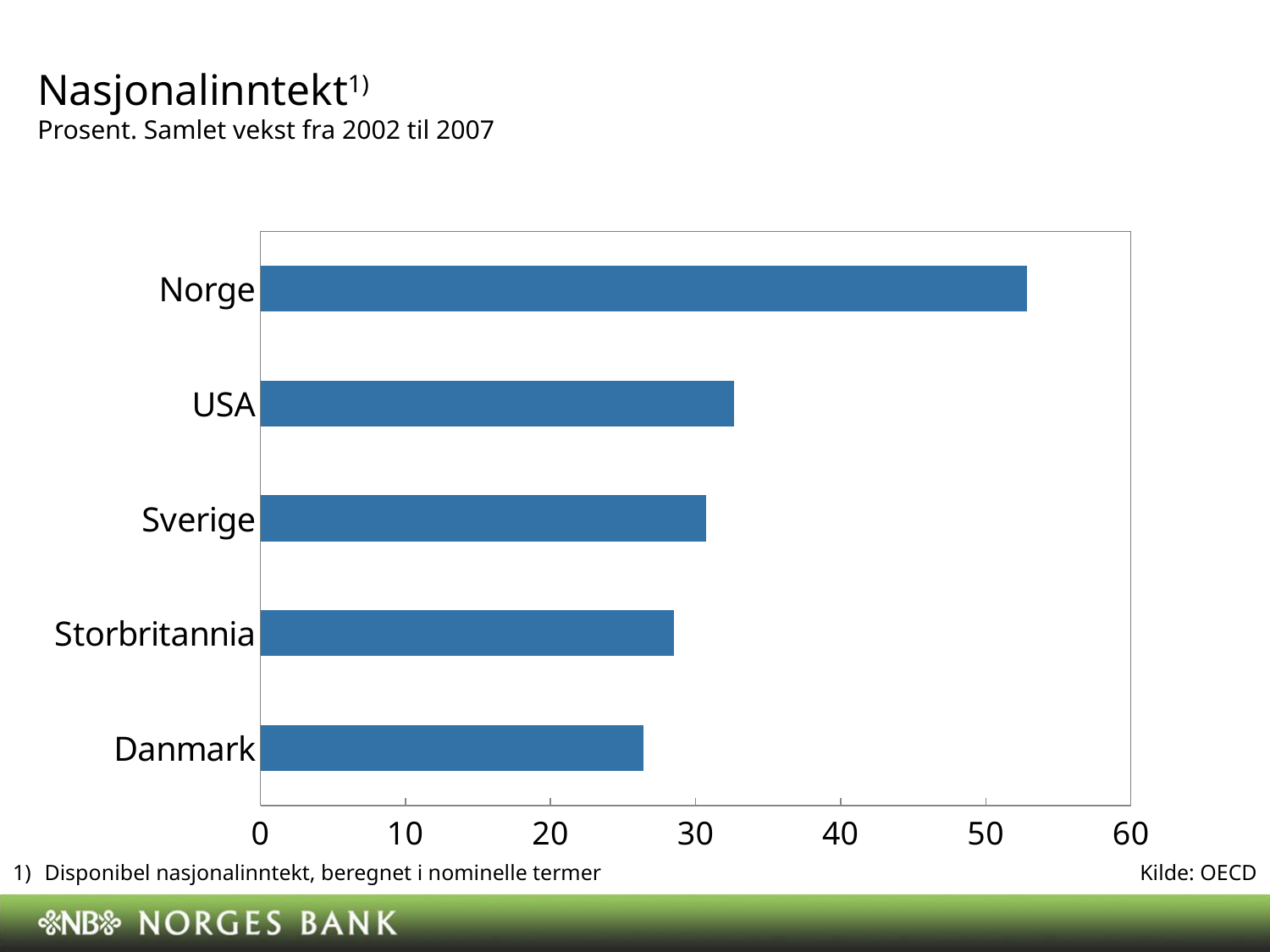
Which country has the highest value in the chart? Norge Is the value for Danmark greater or less than 20? greater Is the value for Norge greater or less than 50? greater Which has the larger value, Norge or USA? Norge What is the source cited for the chart? OECD Which country has the lowest value in the chart? Danmark Is the value for Storbritannia greater or less than 30? less What kind of chart is shown on the slide? bar chart How many countries are shown in the chart? 5 Which has the larger value, Sverige or Danmark? Sverige